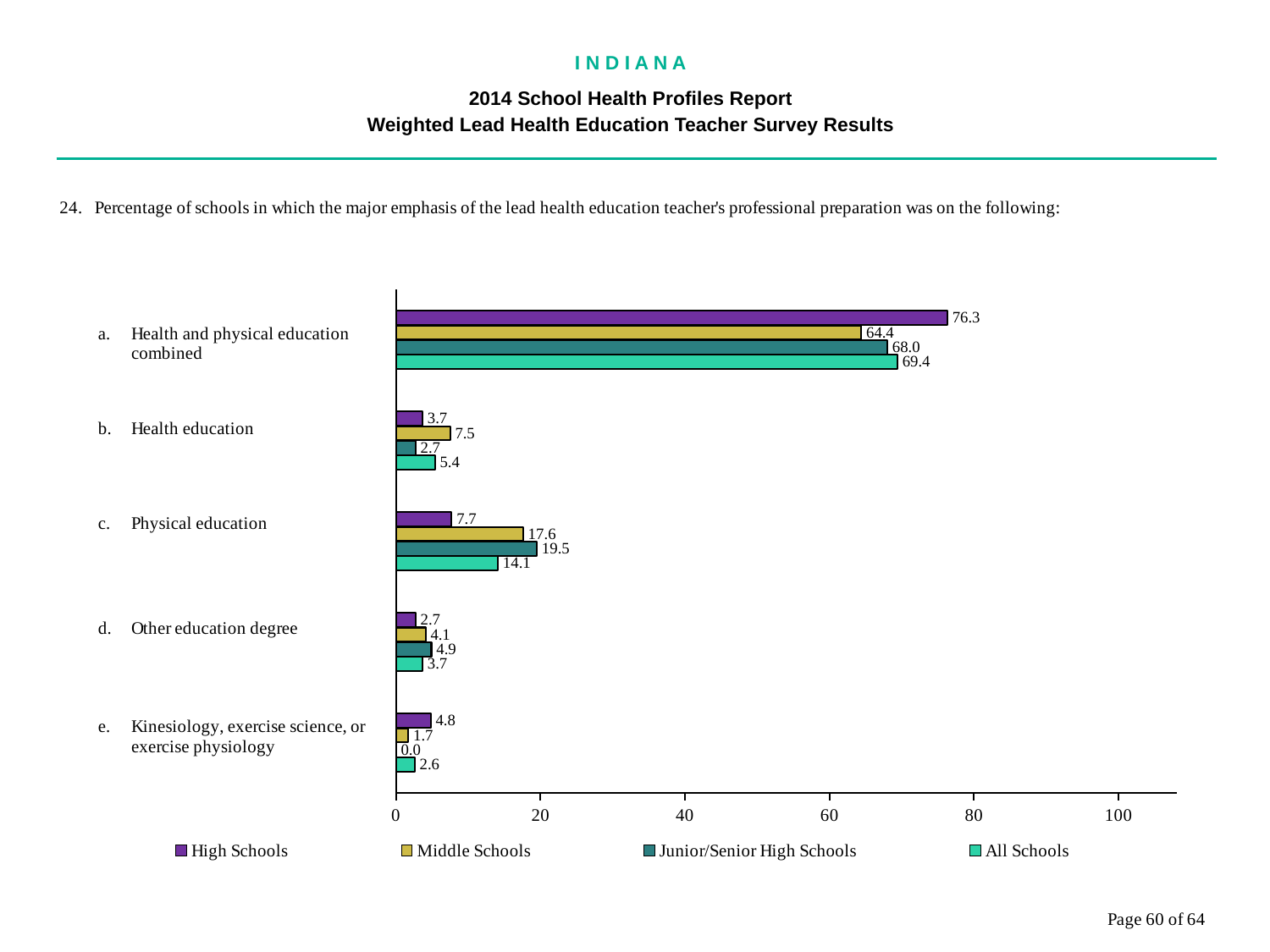
Which category has the highest value for All Schools? Health and physical education combined How many series does the legend list? 4 What is the value for All Schools for 'Health education'? 5.4 Is the value for All Schools for 'Health and physical education combined' greater or less than 60? greater Which category has the lowest value for Middle Schools? Kinesiology, exercise science, or exercise physiology What is the value for High Schools for 'Health and physical education combined'? 76.3 What is the difference between the High Schools and Middle Schools values for 'Health and physical education combined'? 11.9 How many categories are shown on the chart? 5 What is the value for Junior/Senior High Schools for 'Kinesiology, exercise science, or exercise physiology'? 0.0 For 'Physical education', which is larger: the Junior/Senior High Schools value or the High Schools value? Junior/Senior High Schools What is the value for Middle Schools for 'Physical education'? 17.6 What kind of chart is shown on the slide? Bar chart